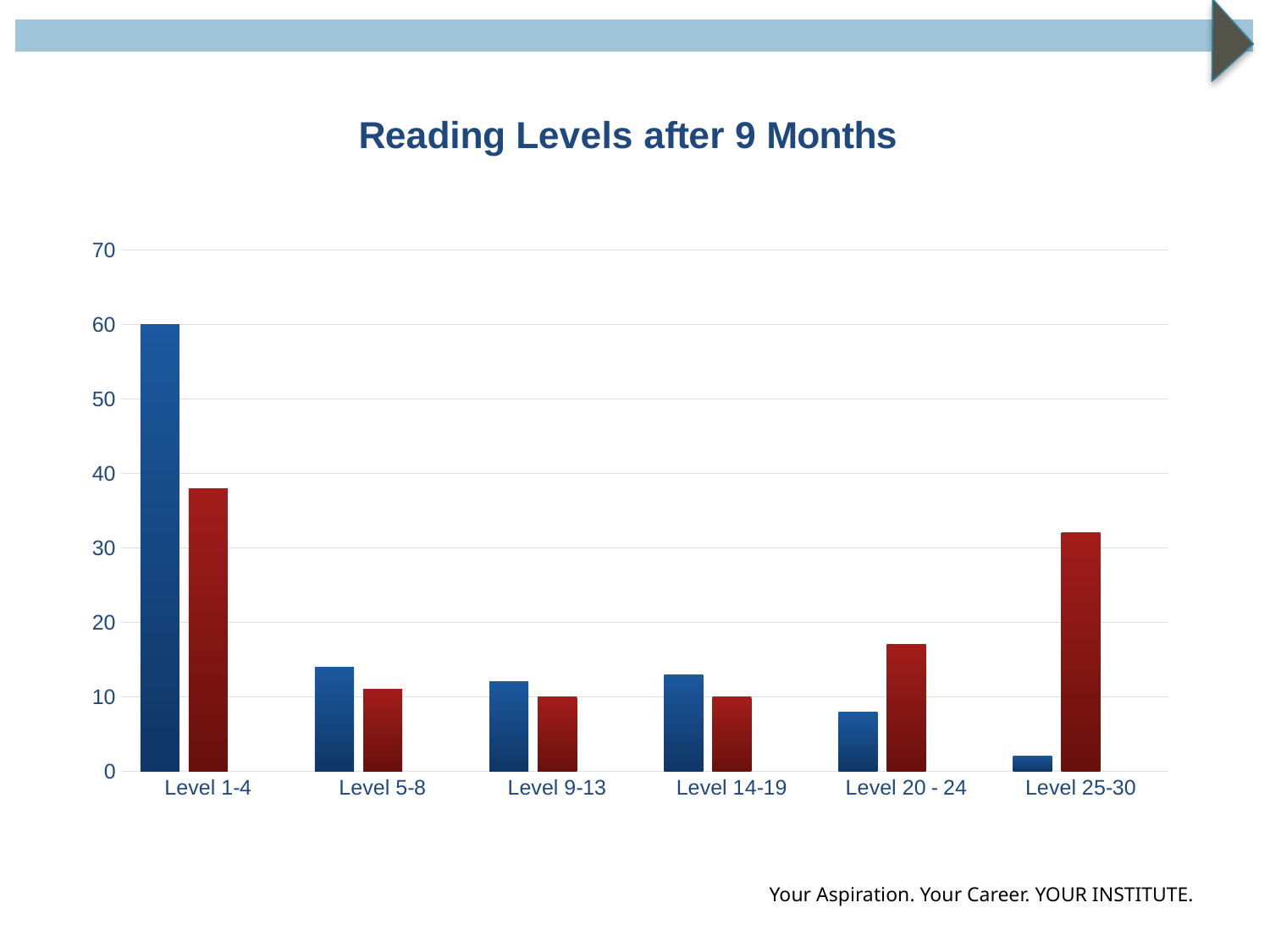
For Level 25-30, which bar is taller, the blue bar or the red bar? the red bar Is the value of the red bar for Level 1-4 greater or less than 40? less Which category has the tallest red bar? Level 1-4 Which category has the shortest blue bar? Level 25-30 What is the value of the blue bar for Level 1-4? 60 For Level 1-4, which bar is taller, the blue bar or the red bar? the blue bar Is the value of the red bar for Level 25-30 greater or less than 30? greater Which category has the tallest blue bar? Level 1-4 What is the title of the chart? Reading Levels after 9 Months Is the value of the blue bar for Level 20 - 24 greater or less than 10? less How many reading level categories are shown on the x axis? 6 What kind of chart is shown on the slide? bar chart